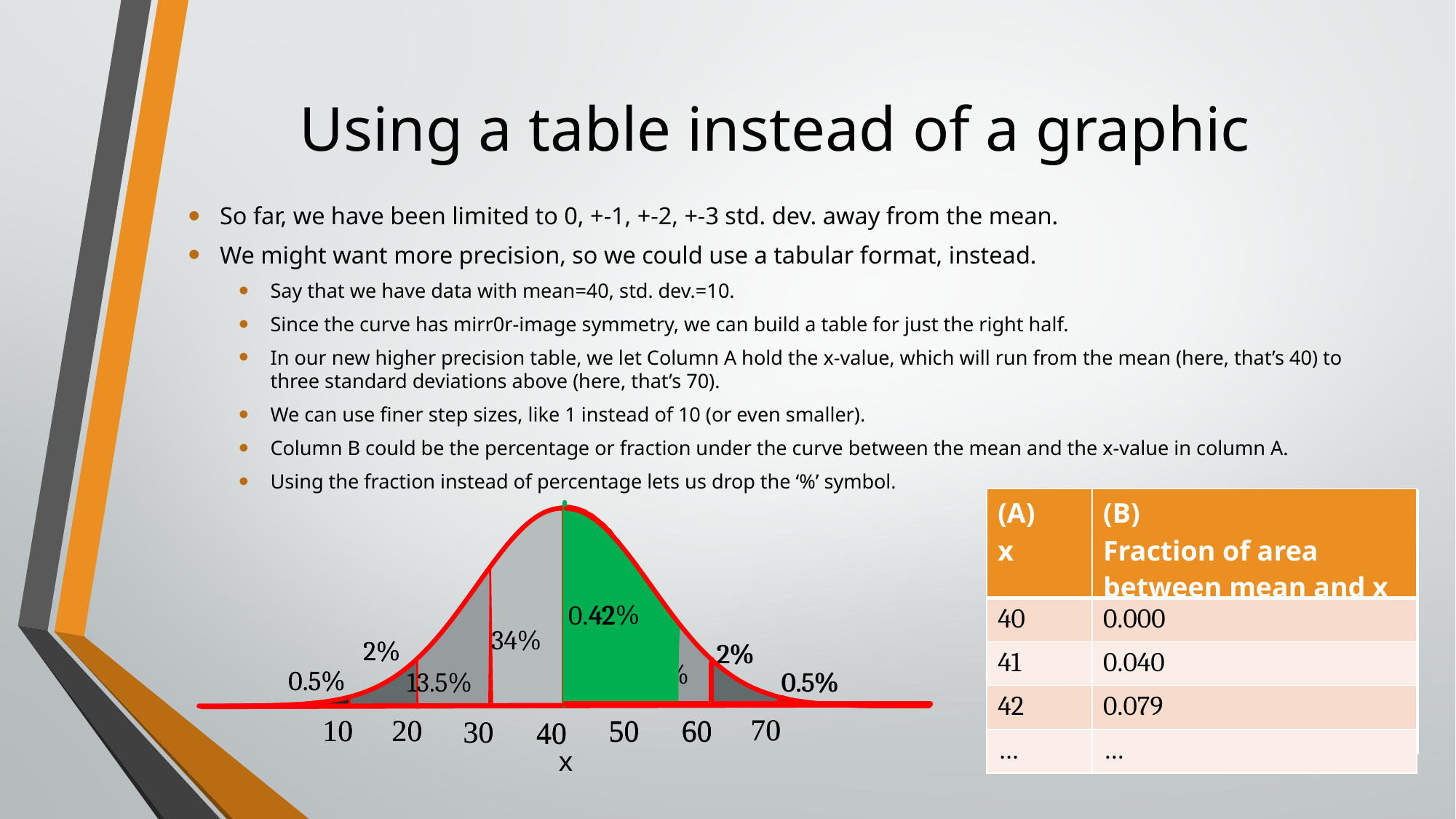
What percentage is labeled for the region between x = 20 and x = 30? 13.5% What percentage is labeled for the leftmost tail of the curve (below x = 10)? 0.5% How many tick labels are shown on the x axis? 7 What is the largest tick value shown on the x axis? 70 What percentage is labeled for the region between x = 60 and x = 70 on the right side? 2% What percentage is labeled for the region between x = 30 and x = 40? 34% What percentage is printed in the green shaded region of the curve? 0.42% What is the difference between the 2% region label and the 0.5% tail label on the left side? 1.5% Which region has the larger labeled percentage: the one between 20 and 30 or the one between 30 and 40? the one between 30 and 40 (34%) What kind of chart is shown at the bottom left of the slide? a bell curve (normal distribution curve) At which x value does the curve reach its peak? 40 What label is printed on the horizontal axis of the bell curve? x